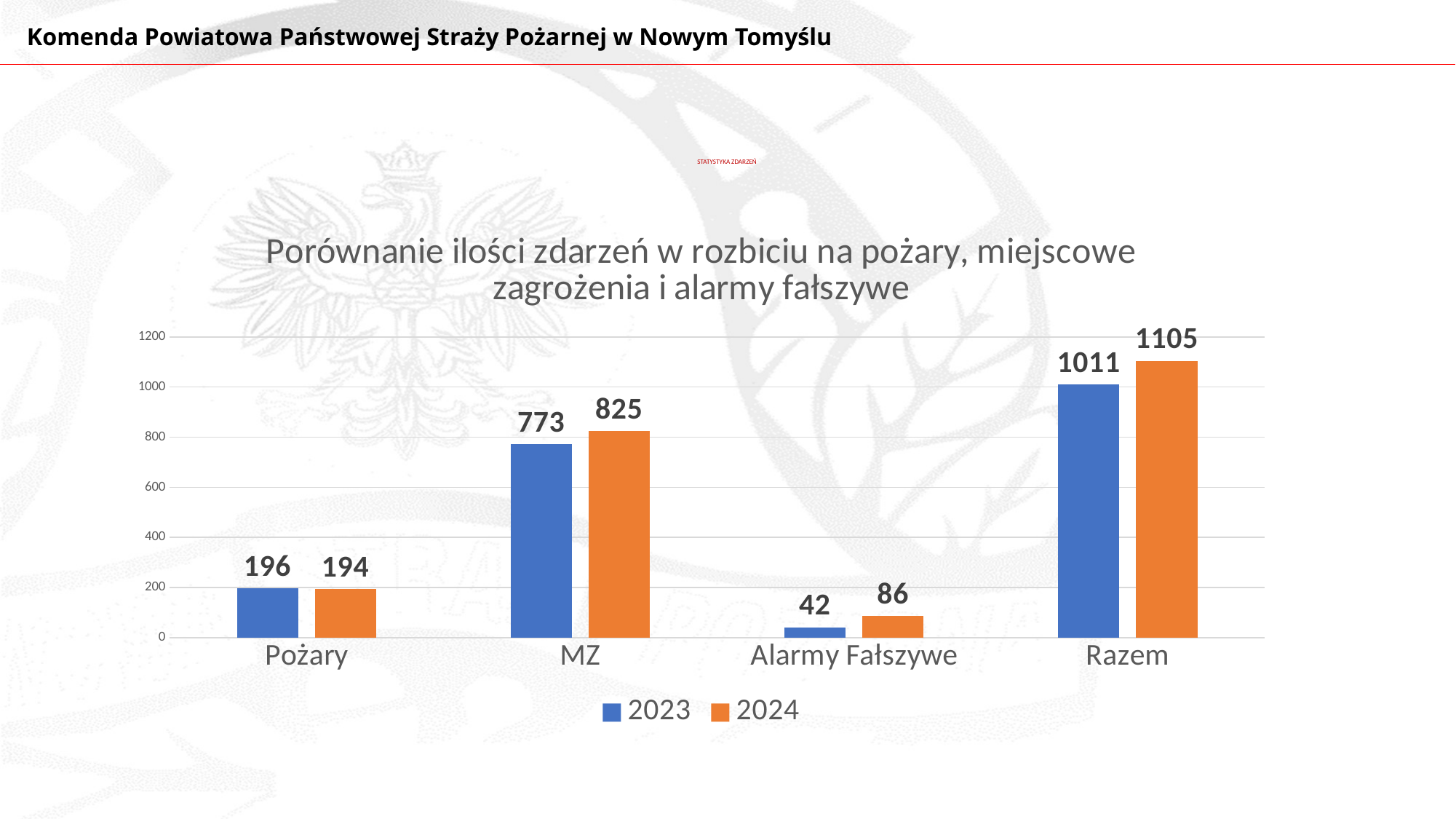
What is the value for Razem in 2024? 1105 Which category has the lowest value in the 2024 series? Alarmy Fałszywe What is the difference between the 2024 and 2023 values for Alarmy Fałszywe? 44 What is the value for Pożary in 2023? 196 How many categories are shown on the x axis? 4 Which is larger for Pożary: the 2023 value or the 2024 value? 2023 What is the value for MZ in 2024? 825 Which category has the highest value in the 2023 series? Razem What is the difference between the 2024 and 2023 values for MZ? 52 What kind of chart is shown on the slide? Bar chart What is the value for Alarmy Fałszywe in 2023? 42 How many series does the legend list? 2